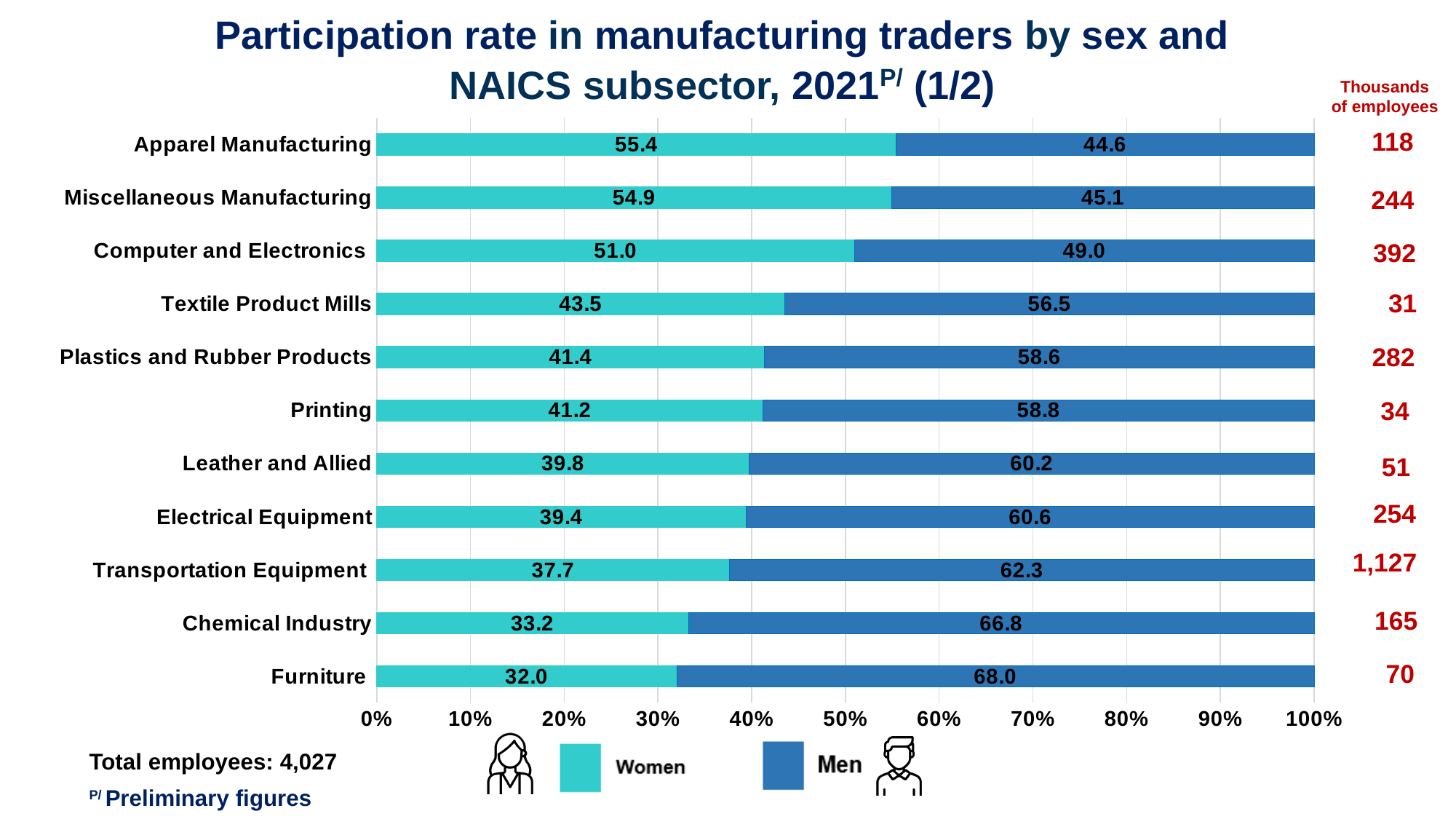
How many subsectors are shown in the chart? 11 Which subsector has the highest Women participation rate? Apparel Manufacturing How many series does the legend list? 2 What is the Women participation rate for Apparel Manufacturing? 55.4 What is the difference between the Men and Women participation rates for Furniture? 36.0 What is the total of the stacked bar for Printing? 100.0 What is the Men participation rate for Chemical Industry? 66.8 Is the Women participation rate for Transportation Equipment greater or less than 40%? less Which is larger for Textile Product Mills, the Women rate or the Men rate? Men What kind of chart is shown on the slide? Stacked bar chart Which colour represents Men in the chart? Dark blue Which subsector has the lowest Women participation rate? Furniture